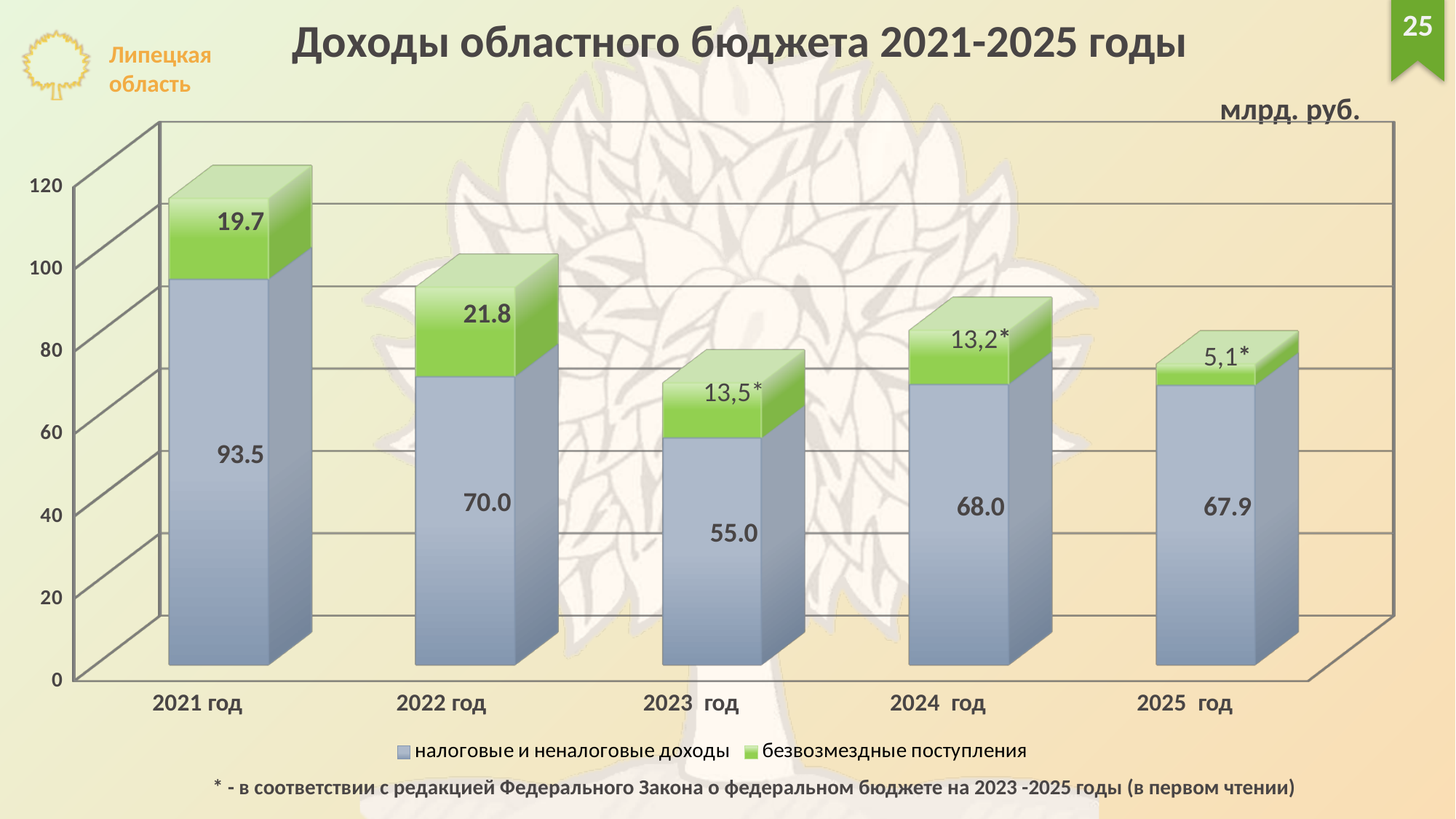
How many years are shown on the x axis? 5 What is the value of безвозмездные поступления for 2025 год? 5,1* What kind of chart is shown on the slide? Stacked bar chart What is the difference between налоговые и неналоговые доходы in 2021 год and 2022 год? 23.5 Which year has the lowest value of безвозмездные поступления? 2025 год Which is larger: безвозмездные поступления in 2021 год or in 2022 год? 2022 год What is the total of the stacked bar for 2021 год? 113.2 Which year has the highest value of налоговые и неналоговые доходы? 2021 год What unit is indicated above the chart? млрд. руб. What is the value of безвозмездные поступления for 2022 год? 21.8 How many series does the legend list? 2 What is the value of налоговые и неналоговые доходы for 2021 год? 93.5